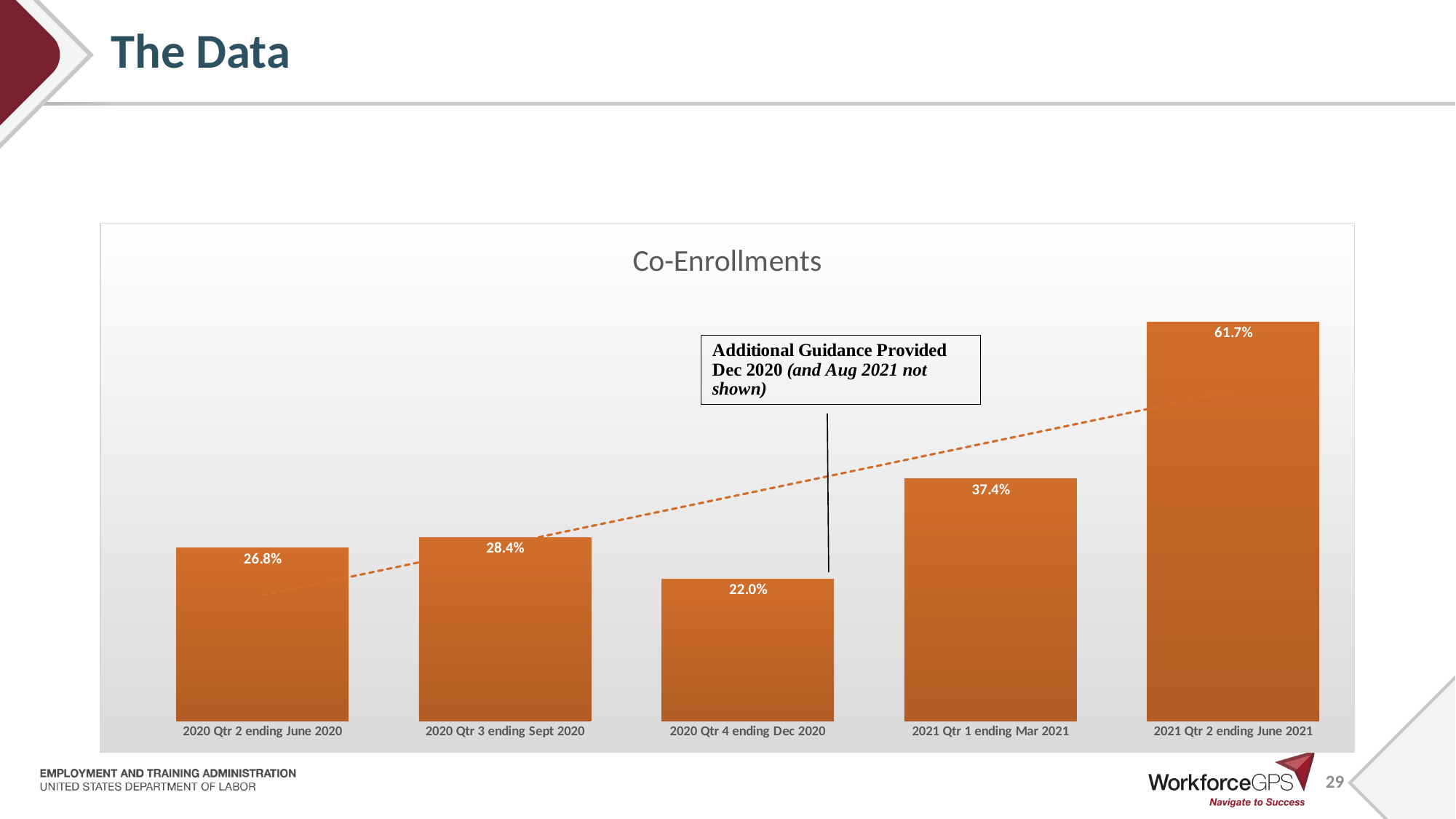
Which is larger, the co-enrollment value for 2020 Qtr 3 ending Sept 2020 or for 2020 Qtr 4 ending Dec 2020? 2020 Qtr 3 ending Sept 2020 How many quarters are shown in the Co-Enrollments chart? 5 What is the co-enrollment value for 2020 Qtr 4 ending Dec 2020? 22.0% Which quarter has the highest co-enrollment value? 2021 Qtr 2 ending June 2021 What is the difference between the co-enrollment values for 2021 Qtr 2 ending June 2021 and 2021 Qtr 1 ending Mar 2021? 24.3% What is the difference between the co-enrollment values for 2020 Qtr 3 ending Sept 2020 and 2020 Qtr 2 ending June 2020? 1.6% What is the co-enrollment value for 2021 Qtr 1 ending Mar 2021? 37.4% What is the co-enrollment value for 2020 Qtr 2 ending June 2020? 26.8% What kind of chart is the Co-Enrollments chart? Bar chart What is the title of the chart? Co-Enrollments What does the annotation box on the chart say? Additional Guidance Provided Dec 2020 (and Aug 2021 not shown) Which quarter has the lowest co-enrollment value? 2020 Qtr 4 ending Dec 2020